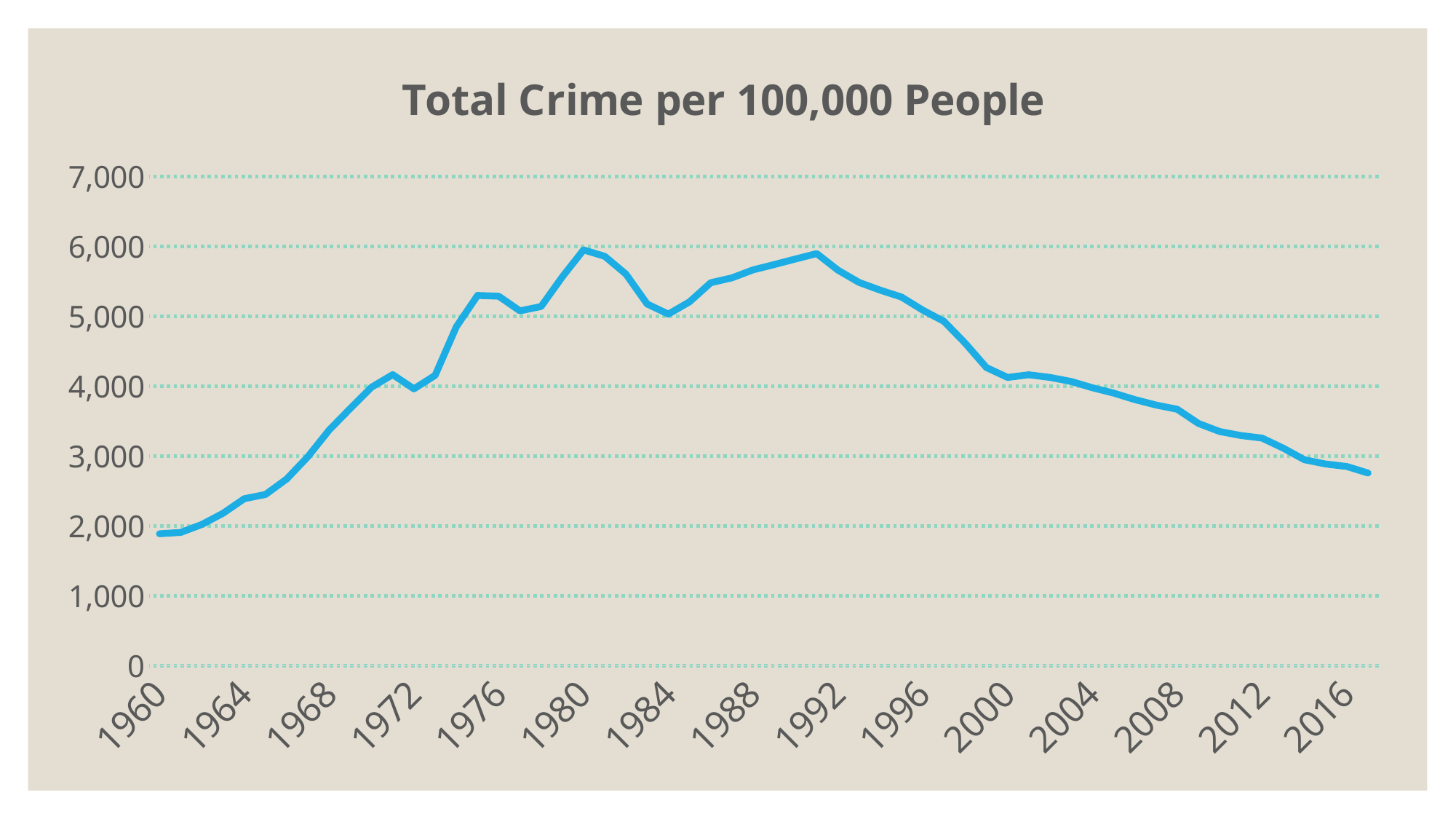
Is the value for 1980 greater or less than 5,000? greater Which is larger, the value for 1960 or the value for 2016? 2016 Is the value for 1992 greater or less than 5,000? greater Is the value for 1960 greater or less than 2,000? less Does the line rise or fall between 1960 and 1980? rise Which year has the lowest value on the chart? 1960 What is the title of the chart? Total Crime per 100,000 People What kind of chart is shown on the slide? line chart Does the line rise or fall between 1992 and 2016? fall